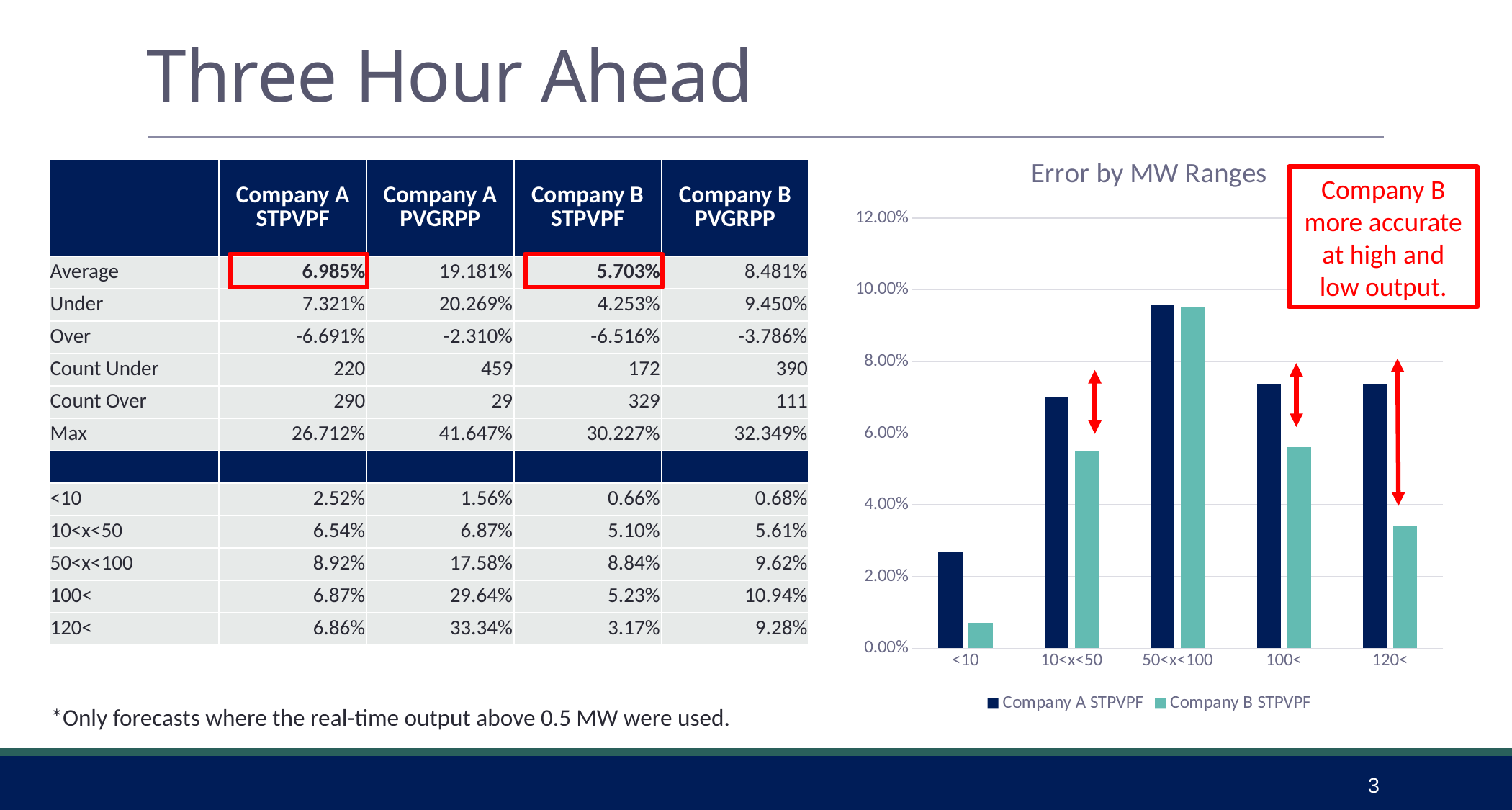
How many series does the chart legend list? 2 Is the value for Company B STPVPF in the 120< range greater or less than 4.00%? less Is the value for Company B STPVPF in the <10 range greater or less than 2.00%? less What is the title of the chart? Error by MW Ranges How many MW range categories are shown on the x axis of the chart? 5 Which MW range has the lowest value for Company A STPVPF? <10 What type of chart is shown on the slide? bar chart Is the value for Company A STPVPF in the 50<x<100 range greater or less than 8.00%? greater Do the Company B STPVPF values rise or fall from the 50<x<100 range to the 120< range? fall Which MW range has the lowest value for Company B STPVPF? <10 In the 120< range, which series has the larger value, Company A STPVPF or Company B STPVPF? Company A STPVPF Which MW range has the highest value for Company A STPVPF? 50<x<100